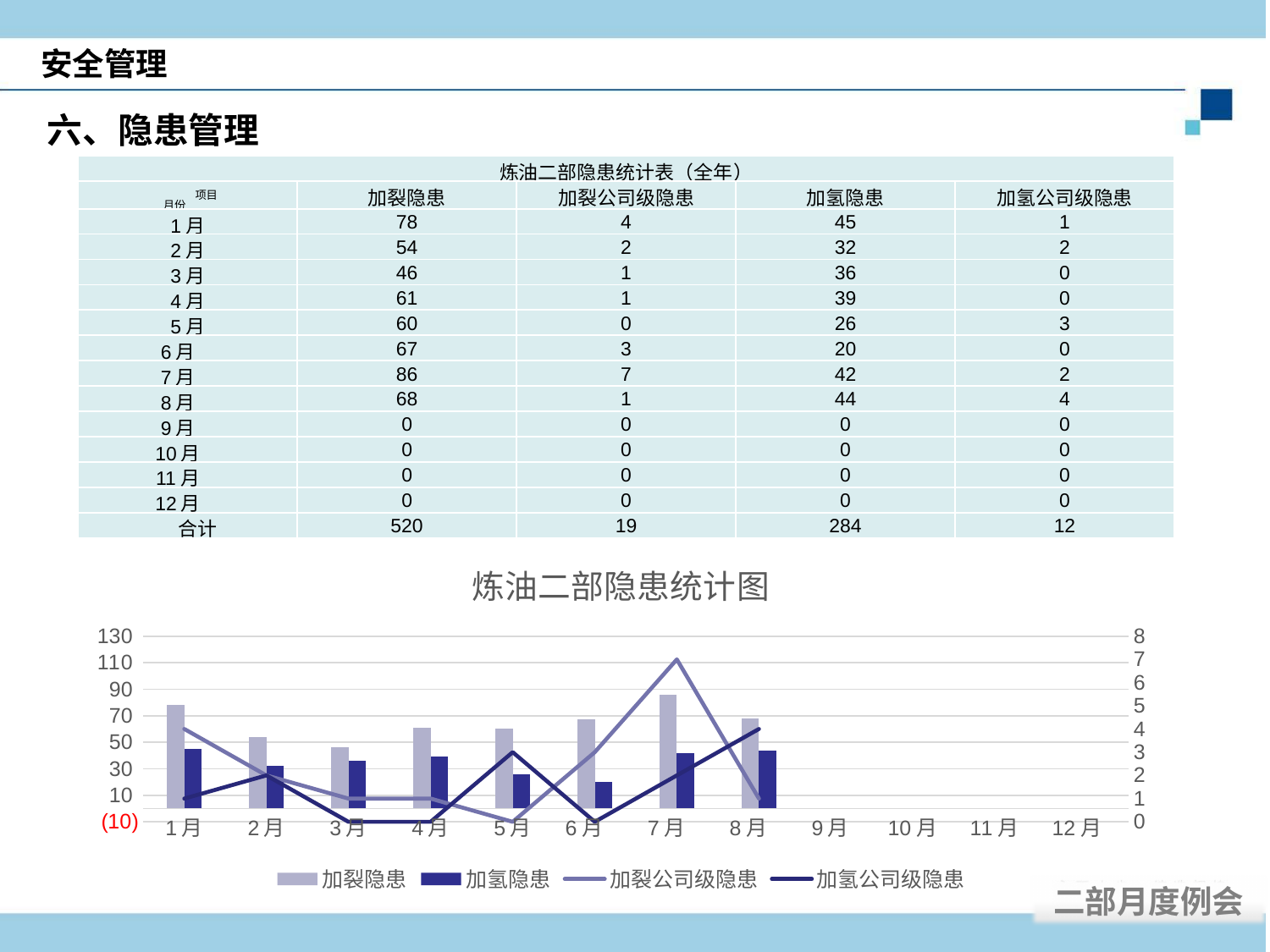
What is the title of the chart on the slide? 炼油二部隐患统计图 What kind of chart is 炼油二部隐患统计图? Combined bar and line chart Does the 加裂公司级隐患 line rise or fall from 1月 to 5月? fall How many series does the chart legend list? 4 In which month does the 加氢公司级隐患 line reach its highest point? 8月 Is the 加裂隐患 value for 7月 greater or less than 70? greater In which month is the 加裂隐患 bar highest? 7月 How many month categories are shown on the x axis of the chart? 12 In which month does the 加裂公司级隐患 line reach its peak? 7月 Is the 加氢隐患 value for 6月 greater or less than 30? less In 1月, which bar is taller, 加裂隐患 or 加氢隐患? 加裂隐患 Which two series in the chart are drawn as lines rather than bars? 加裂公司级隐患 and 加氢公司级隐患